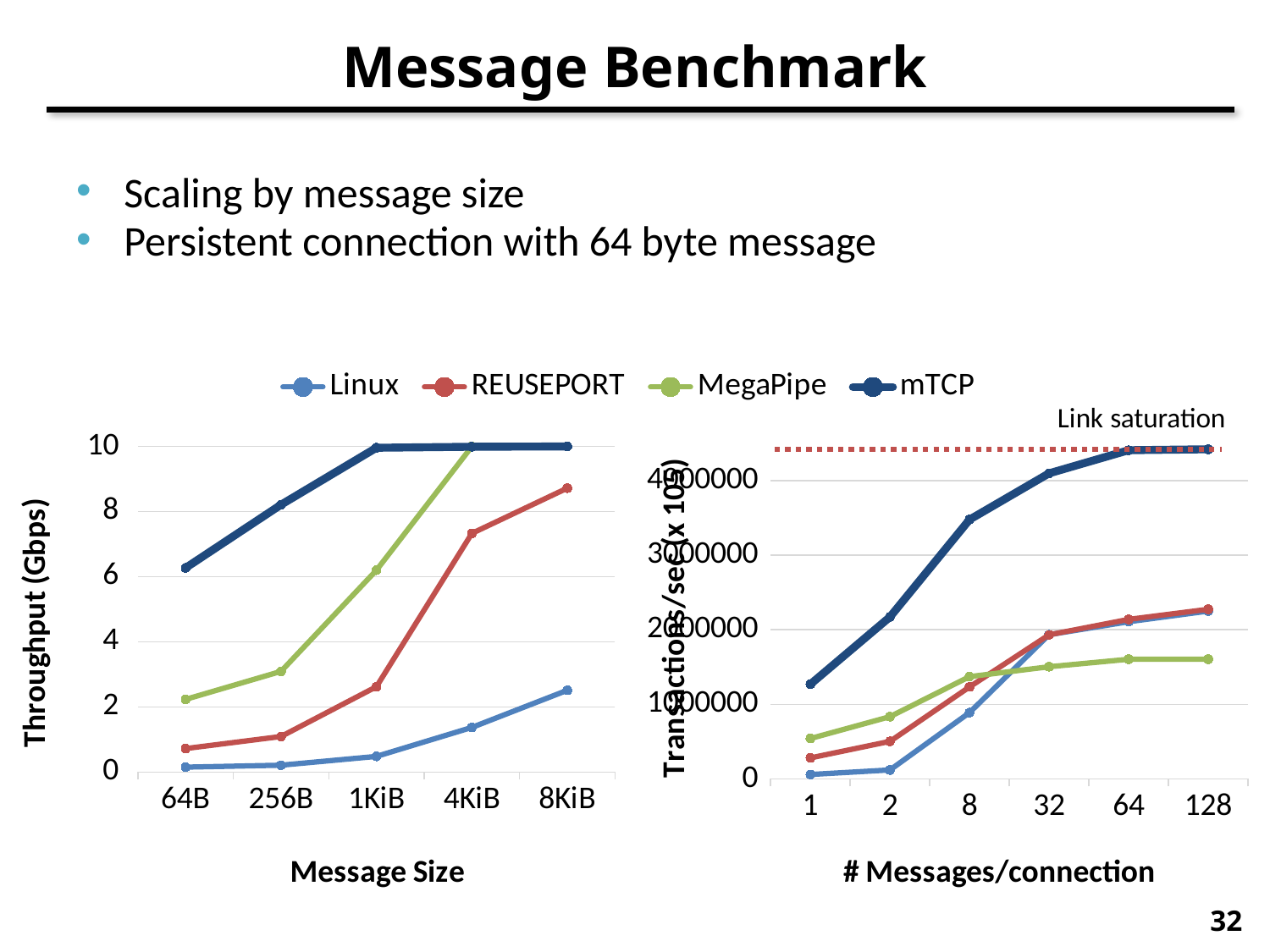
In the left chart, is the throughput of MegaPipe at 1KiB greater or less than 4? greater In the right chart, how many values of # Messages/connection are shown on the x axis? 6 In the right chart, which series has the highest transactions/sec at 8 messages per connection? mTCP In the right chart, what does the label next to the dotted horizontal line say? Link saturation In the left chart, what is the throughput of mTCP at 8KiB? 10 In the left chart, is the throughput of REUSEPORT at 1KiB greater or less than 4? less In the left chart, which series has the highest throughput at 64B? mTCP In the left chart, how many message sizes are shown on the x axis? 5 In the left chart, which has the higher throughput at 4KiB, REUSEPORT or Linux? REUSEPORT In the left chart, which series has the lowest throughput at 8KiB? Linux How many series does the legend list? 4 What kind of chart is the left chart (Throughput vs Message Size)? line chart